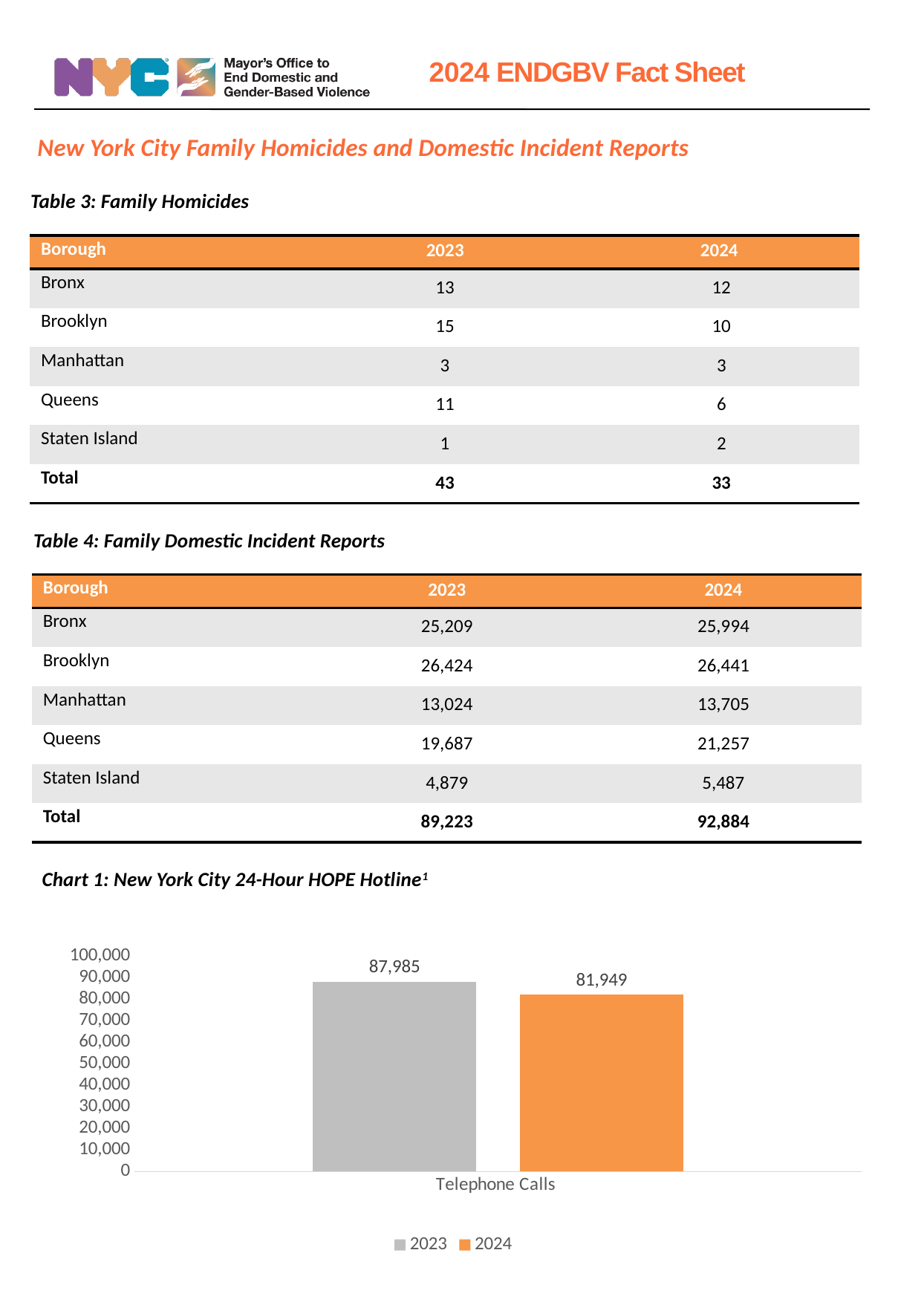
In Chart 1, which year has the higher number of telephone calls? 2023 What is the category label on the x axis of Chart 1? Telephone Calls In Chart 1, which colour represents the 2024 series? orange In Chart 1, is the value for 2024 greater or less than 90,000? less In Chart 1, is the value for 2023 greater or less than 80,000? greater What kind of chart is Chart 1? bar chart In Chart 1, what is the value for 2023 telephone calls? 87,985 In Chart 1, is the 2024 value larger or smaller than the 2023 value? smaller In Chart 1, which year has the lower number of telephone calls? 2024 How many series does the legend of Chart 1 list? 2 In Chart 1, what is the difference between the 2023 and 2024 telephone call values? 6,036 In Chart 1, what is the value for 2024 telephone calls? 81,949